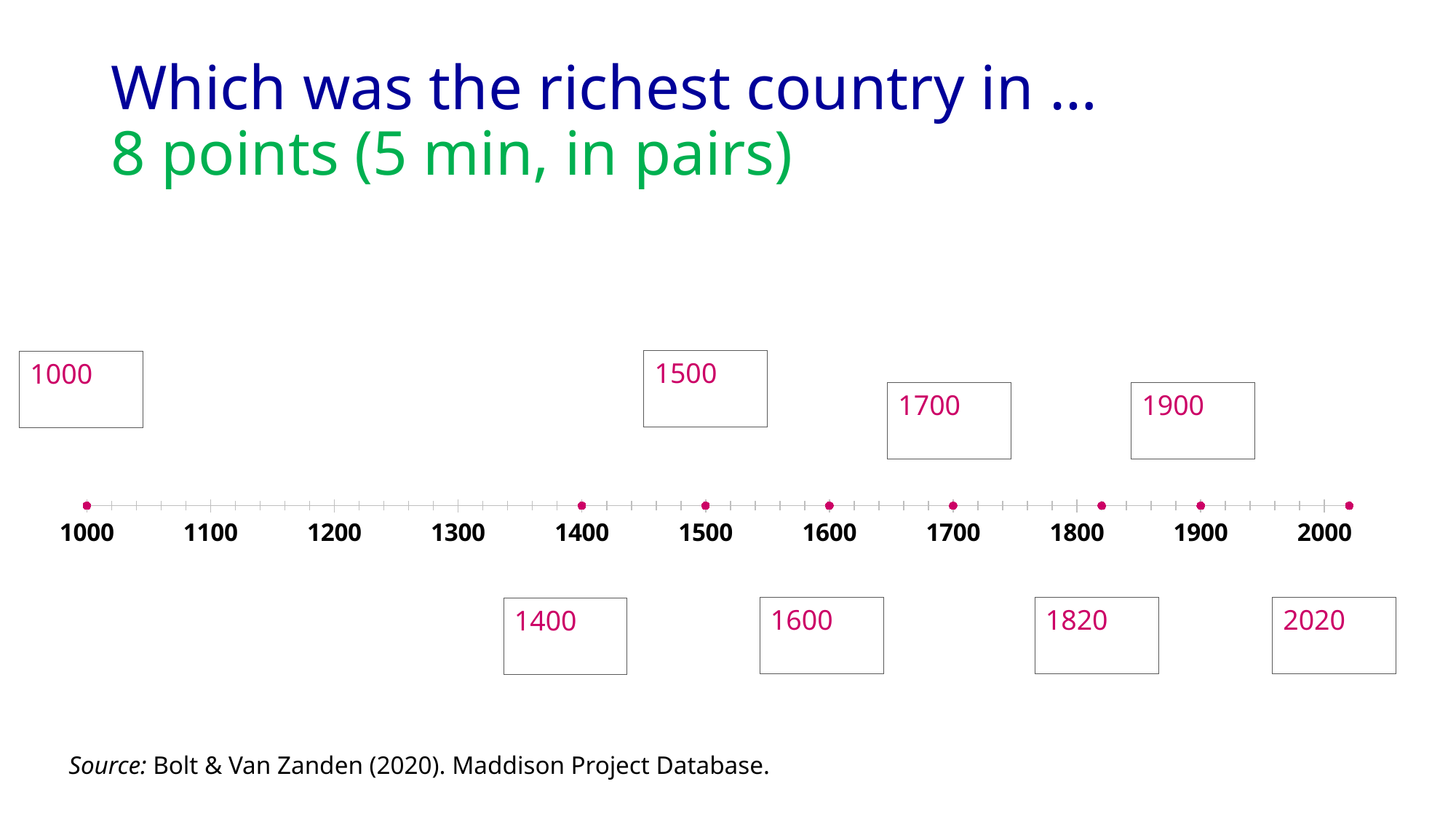
How many years are there between the marked points 1000 and 1400? 400 What is the interval between the labelled axis ticks on the timeline? 100 Is the marked point 1820 greater or less than 1800 on the axis? greater How many marked points are there on the timeline? 8 What is the last axis tick label on the timeline? 2000 What is the latest year marked on the timeline? 2020 What is the earliest year marked on the timeline? 1000 How many years separate the first and last marked points on the timeline? 1020 Which marked year lies between 1800 and 1900 on the timeline? 1820 Which is later on the timeline, the marked point 1700 or the marked point 1600? 1700 What source is cited below the timeline? Bolt & Van Zanden (2020). Maddison Project Database. What is the first axis tick label on the timeline? 1000